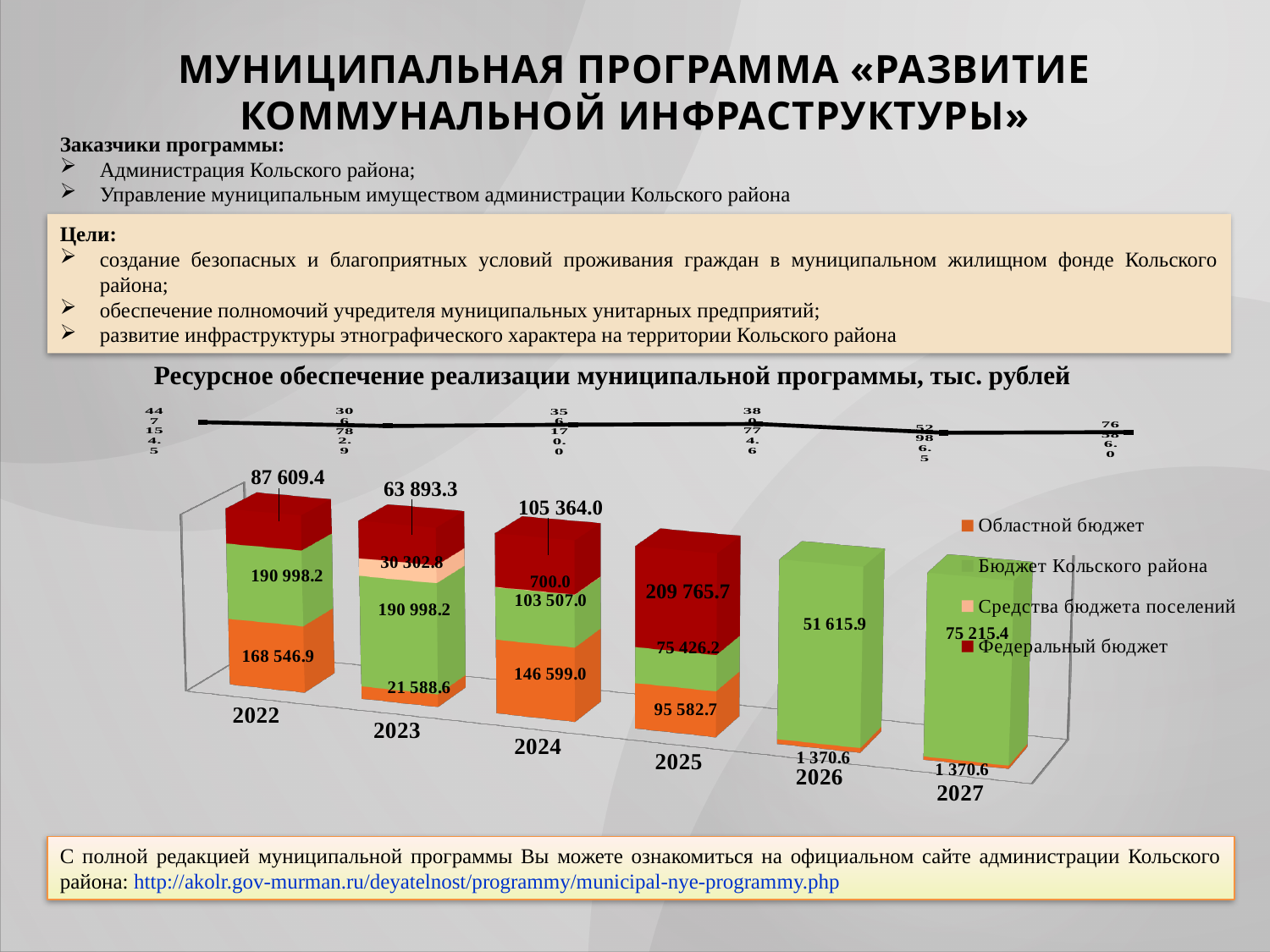
What is the value of Федеральный бюджет for 2025? 209 765.7 What is the value of Областной бюджет for 2022? 168 546.9 What is the total of the stacked bar for 2022? 447 154.5 Which is larger: Областной бюджет in 2024 or Бюджет Кольского района in 2024? Областной бюджет in 2024 How many years are shown on the x axis of the chart? 6 Which year has the highest value for Федеральный бюджет? 2025 How many series does the legend of the chart list? 4 What is the difference between Областной бюджет in 2022 and in 2023? 146 958.3 What kind of chart is used to show the resource provision of the municipal programme? stacked bar chart What is the value of Бюджет Кольского района for 2027? 75 215.4 What is the value of Средства бюджета поселений for 2024? 700.0 Which year has the lowest value for Бюджет Кольского района? 2026